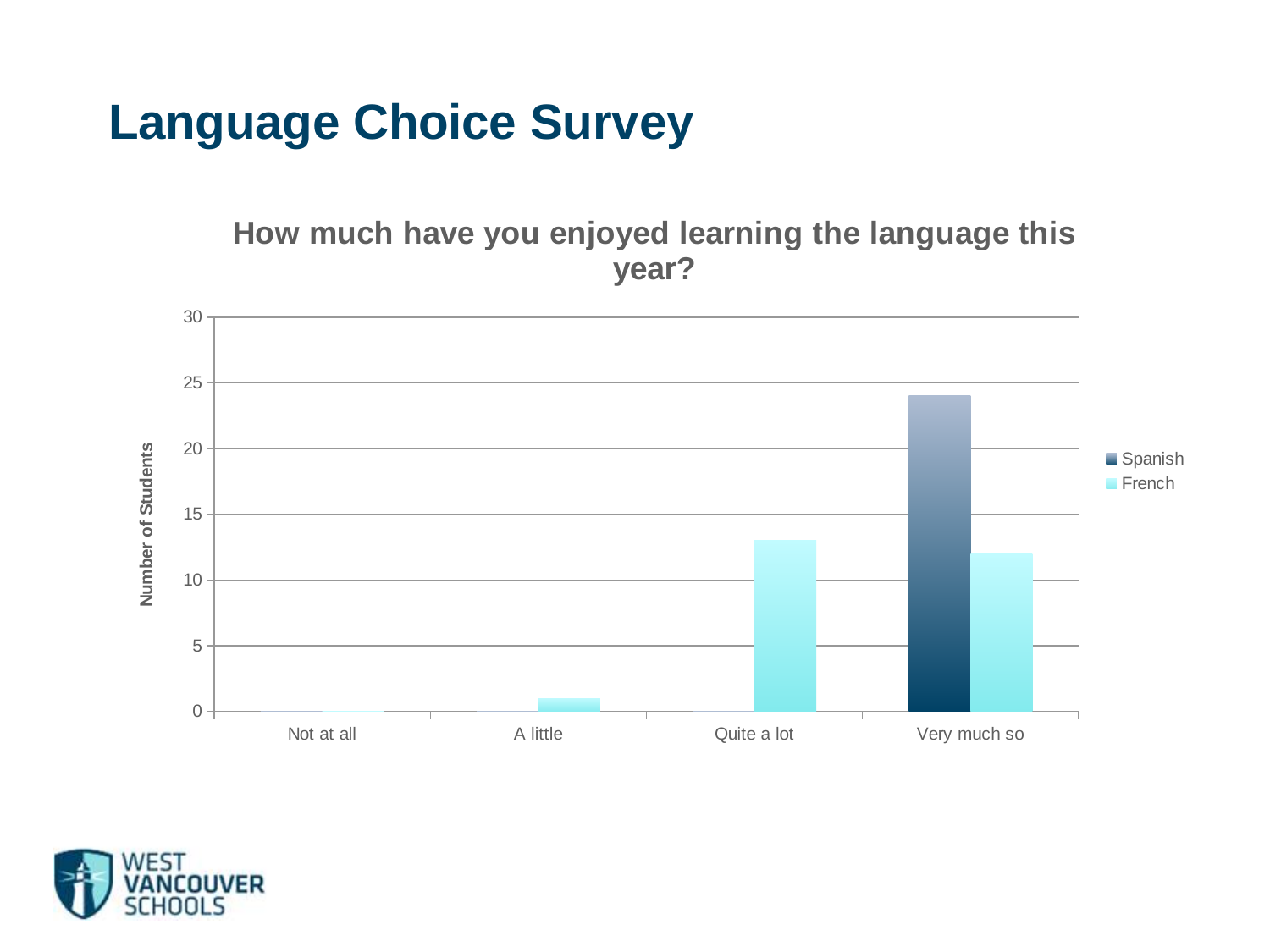
What is the label of the vertical axis? Number of Students How many series does the legend list? 2 Which category has the highest French bar? Quite a lot Is the Spanish value for Very much so greater or less than 20? greater What kind of chart is shown on the slide? bar chart For Very much so, which series has the larger value, Spanish or French? Spanish How many categories are shown on the x axis? 4 Do the French values rise or fall from Not at all to Quite a lot? rise Which category has the highest Spanish bar? Very much so Is the French value for A little greater or less than 5? less Is the French value for Quite a lot greater or less than 10? greater What is the title of the chart? How much have you enjoyed learning the language this year?